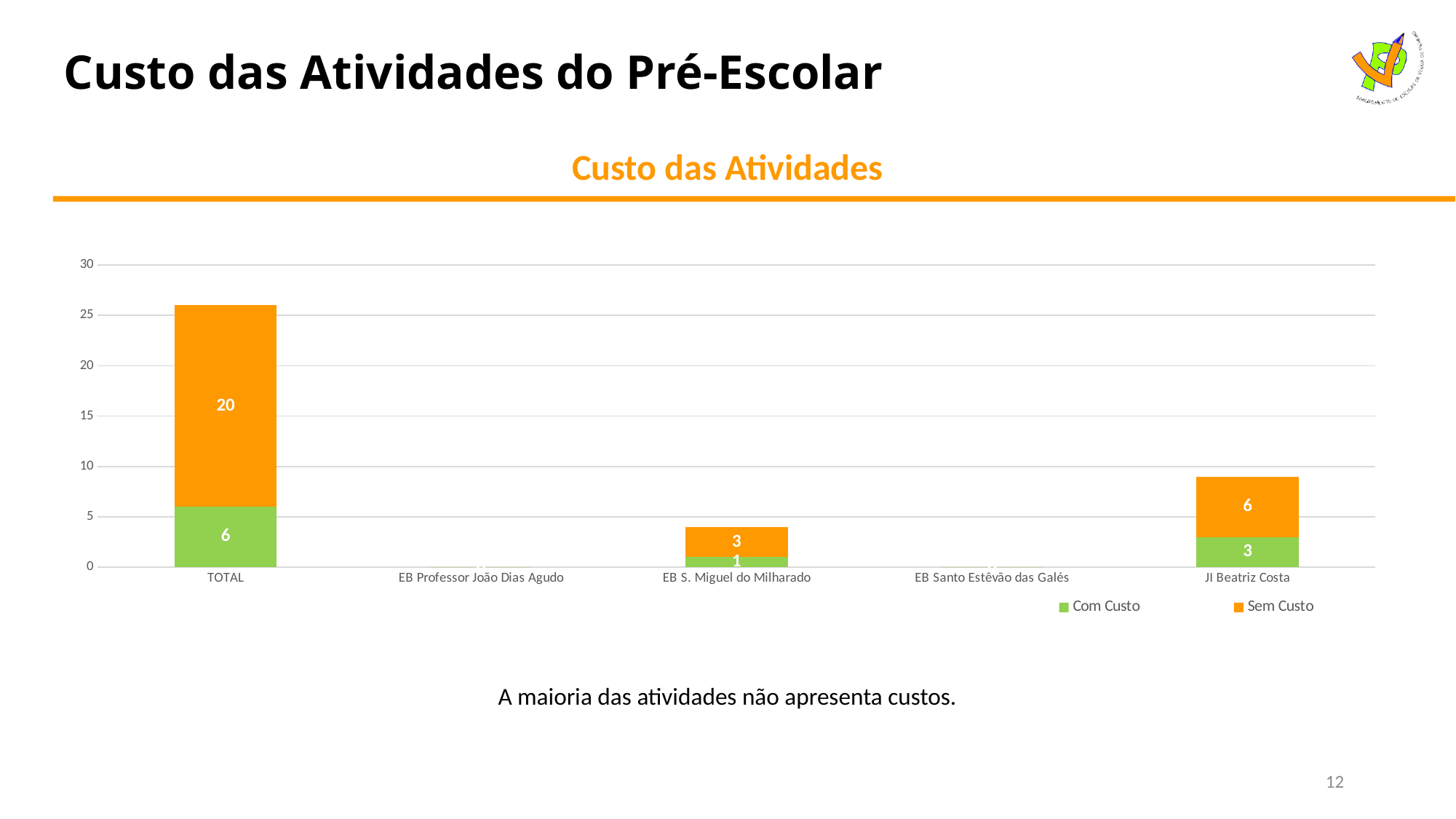
What is the title of the chart? Custo das Atividades Is the Com Custo value for JI Beatriz Costa larger or smaller than the Com Custo value for EB S. Miguel do Milharado? larger How many series does the legend list? 2 What is the Com Custo value for JI Beatriz Costa? 3 What is the difference between the Sem Custo and Com Custo values for TOTAL? 14 Which school has the highest Sem Custo value? JI Beatriz Costa What type of chart is shown on the slide? Stacked bar chart What is the Sem Custo value for TOTAL? 20 How many categories are shown on the x axis? 5 What is the total of the stacked bar for TOTAL? 26 What is the Sem Custo value for EB S. Miguel do Milharado? 3 What is the total of the stacked bar for JI Beatriz Costa? 9